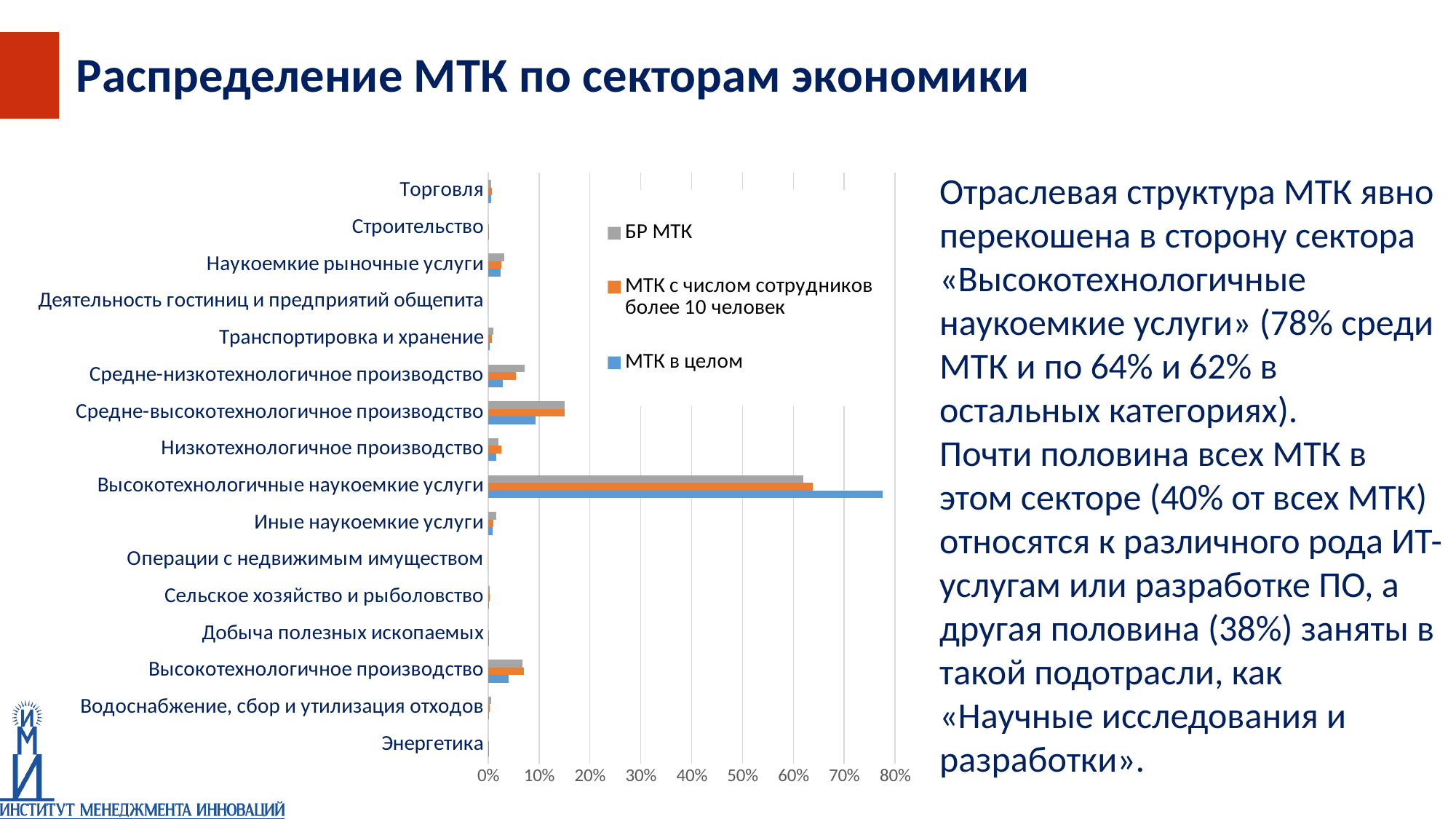
For «Высокотехнологичные наукоемкие услуги», which series has the larger value: «МТК в целом» or «БР МТК»? МТК в целом Which sector has the highest value for the series «МТК в целом»? Высокотехнологичные наукоемкие услуги How many series does the chart legend list? 3 Which sector has the second-highest value for the series «МТК в целом»? Средне-высокотехнологичное производство Is the value of «БР МТК» for «Средне-высокотехнологичное производство» greater or less than 10%? greater Is the value of «МТК в целом» for «Высокотехнологичные наукоемкие услуги» greater or less than 70%? greater What kind of chart is shown on the slide? bar chart What colour represents the series «МТК в целом» in the chart legend? blue How many sector categories are shown on the chart's vertical axis? 16 For «Средне-высокотехнологичное производство», which series has the larger value: «БР МТК» or «МТК в целом»? БР МТК Is the value of «БР МТК» for «Высокотехнологичные наукоемкие услуги» greater or less than 70%? less For the series «БР МТК», which sector has the larger value: «Средне-высокотехнологичное производство» or «Высокотехнологичное производство»? Средне-высокотехнологичное производство